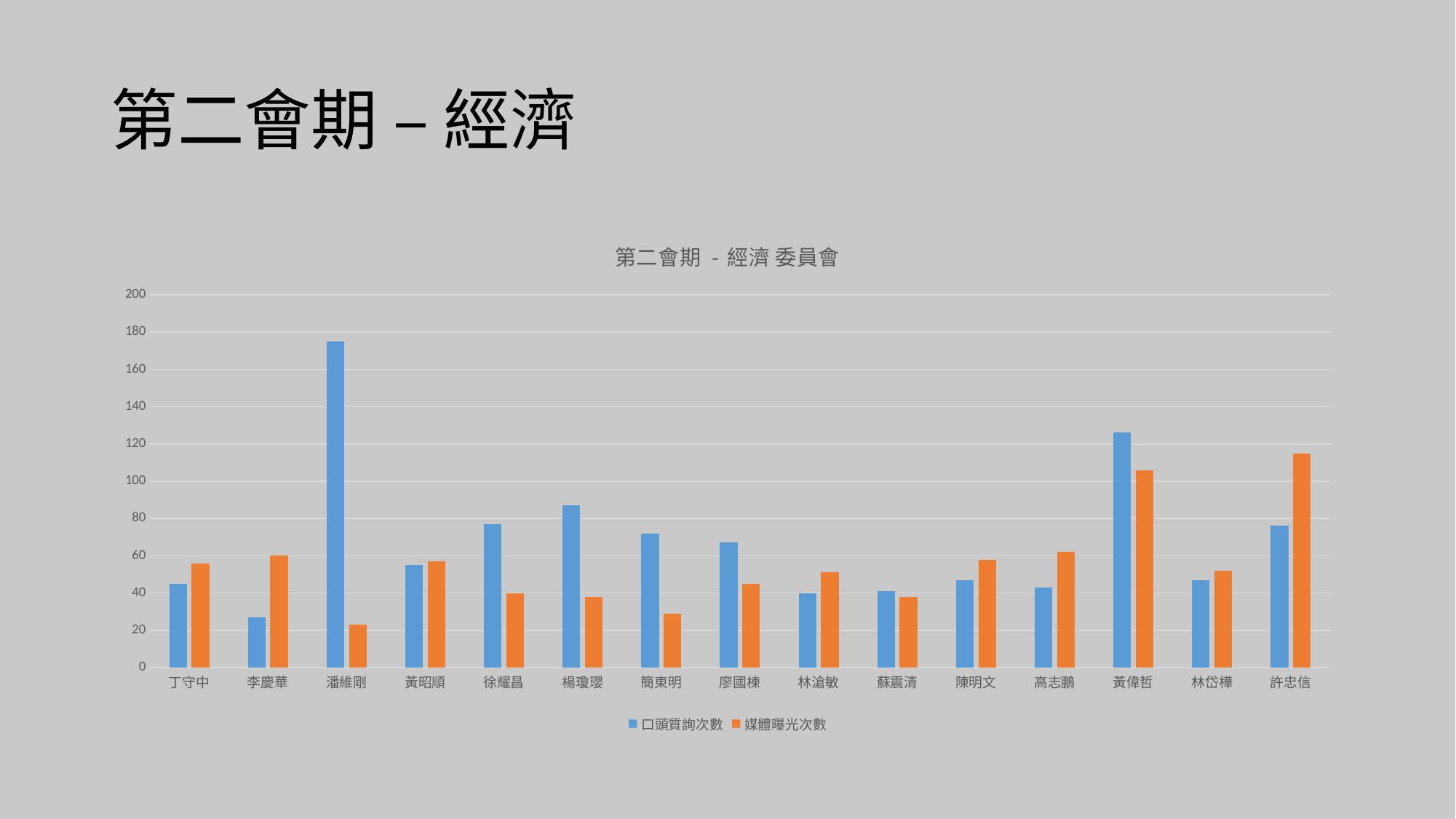
Which legislator has the lowest 口頭質詢次數? 李慶華 What is the title of the chart? 第二會期 - 經濟 委員會 Which legislator has the highest 媒體曝光次數? 許忠信 How many legislators (categories) are shown on the x axis? 15 Which legislator has the lowest 媒體曝光次數? 潘維剛 Is the 口頭質詢次數 value for 李慶華 greater or less than 40? less Is the 口頭質詢次數 value for 潘維剛 greater or less than 160? greater What kind of chart is shown on the slide? bar chart How many series does the legend list? 2 Which legislator has the highest 口頭質詢次數? 潘維剛 Is the 媒體曝光次數 value for 許忠信 greater or less than 100? greater For 許忠信, which is larger: 口頭質詢次數 or 媒體曝光次數? 媒體曝光次數